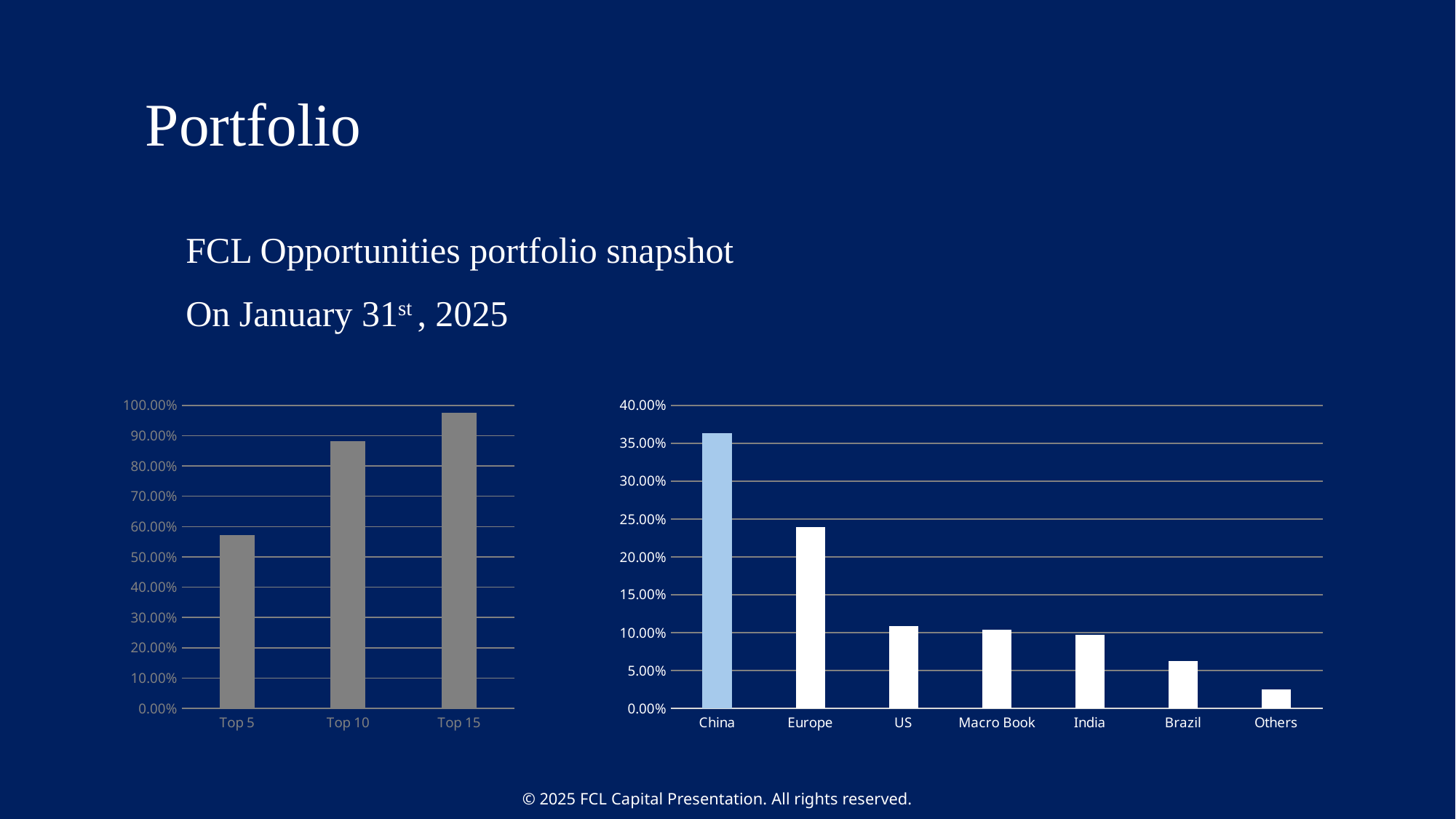
On the right chart, is the value for China greater or less than 35.00%? greater On the right chart, which is larger, the value for Brazil or the value for Others? Brazil On the right chart, which category has the highest value? China On the left chart, is the value for Top 5 greater or less than 50.00%? greater What kind of chart is the left chart with Top 5, Top 10 and Top 15? Bar chart On the right chart, which category has the lowest value? Others How many categories are shown on the right chart (China through Others)? 7 On the left chart, which category has the highest value? Top 15 On the left chart, is the value for Top 10 greater or less than 90.00%? less On the right chart, which category's bar is coloured light blue rather than white? China On the left chart, do the values rise or fall from Top 5 to Top 15? Rise